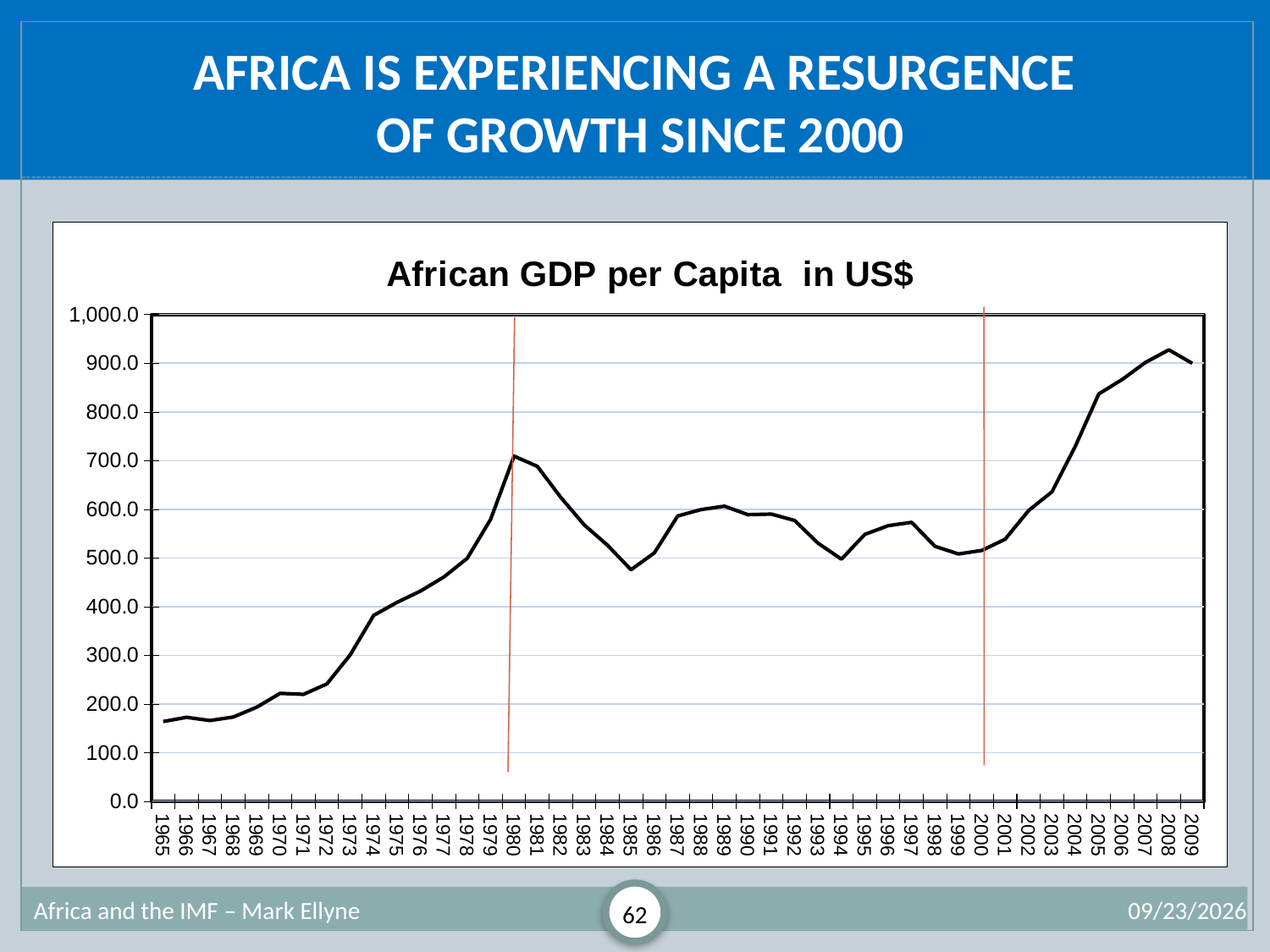
What kind of chart is shown on the slide? line chart Is the value for 1985 greater or less than 500? less In which year does African GDP per capita reach its highest value on the chart? 2008 How many years are plotted along the x axis of the chart? 45 Which year has the larger GDP per capita, 1985 or 1989? 1989 Is the value for 1972 greater or less than 300? less Is the value for 2003 greater or less than 600? greater Does African GDP per capita rise or fall between 2000 and 2008? rise Which year has the larger GDP per capita, 1980 or 2008? 2008 What is the title of the chart? African GDP per Capita in US$ Does African GDP per capita rise or fall between 1980 and 1985? fall